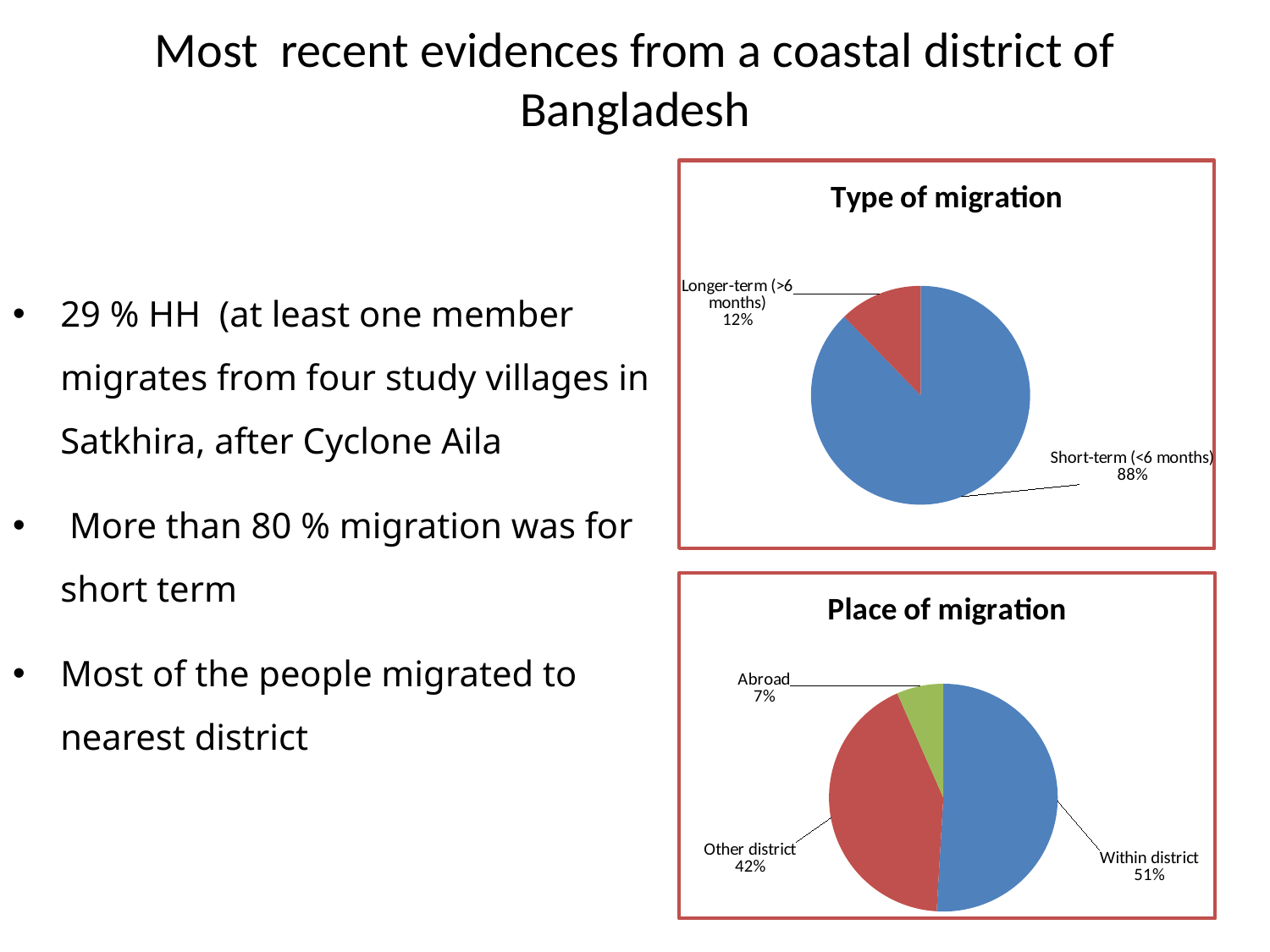
In the 'Place of migration' chart, what is the difference in percentage points between within district and other district? 9 percentage points In the 'Place of migration' chart, what share of migration is within district? 51% In the 'Place of migration' chart, what share of migration is abroad? 7% In the 'Place of migration' chart, how many slices does the pie have? 3 In the 'Type of migration' chart, which slice is the largest? Short-term (<6 months) In the 'Type of migration' chart, what share of migration is longer-term (>6 months)? 12% In the 'Place of migration' chart, which slice is the smallest? Abroad In the 'Place of migration' chart, which is larger: within district or other district? Within district In the 'Type of migration' chart, how many slices does the pie have? 2 What kind of chart is the 'Type of migration' chart? Pie chart